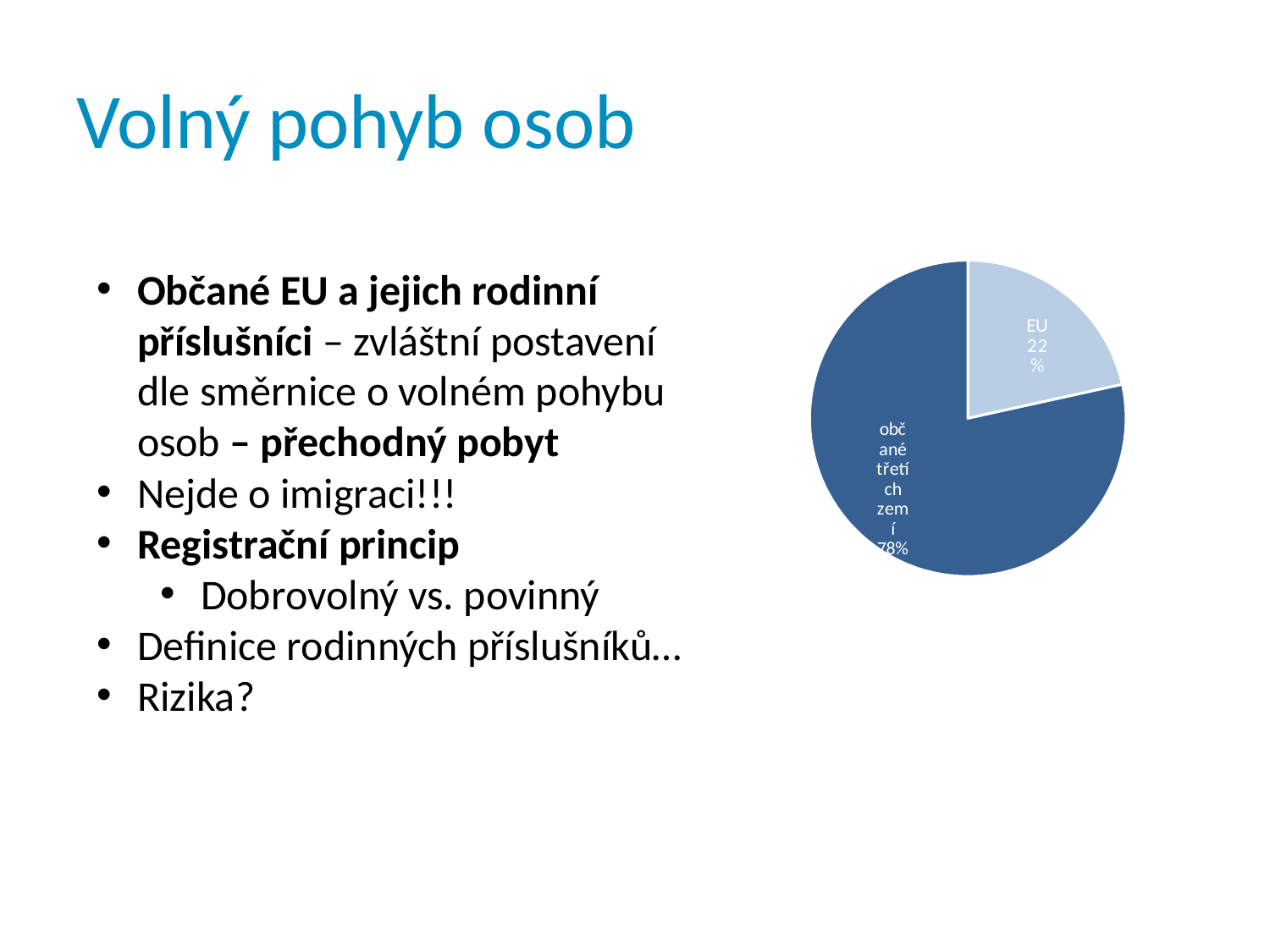
Which is larger in the pie chart, the EU slice or the 'občané třetích zemí' slice? občané třetích zemí How many slices does the pie chart have? 2 Is the share of the EU slice greater or less than 50%? less What share of the pie does the EU slice represent? 22% Which slice of the pie chart is the smallest? EU What kind of chart is shown on the slide? pie chart Which slice of the pie chart is drawn in the lighter blue colour? EU Is the share of the 'občané třetích zemí' slice greater or less than 50%? greater What is the title of the slide containing the pie chart? Volný pohyb osob Which slice of the pie chart is the largest? občané třetích zemí What is the difference in percentage points between the 'občané třetích zemí' slice and the EU slice? 56 What share of the pie does the 'občané třetích zemí' slice represent? 78%